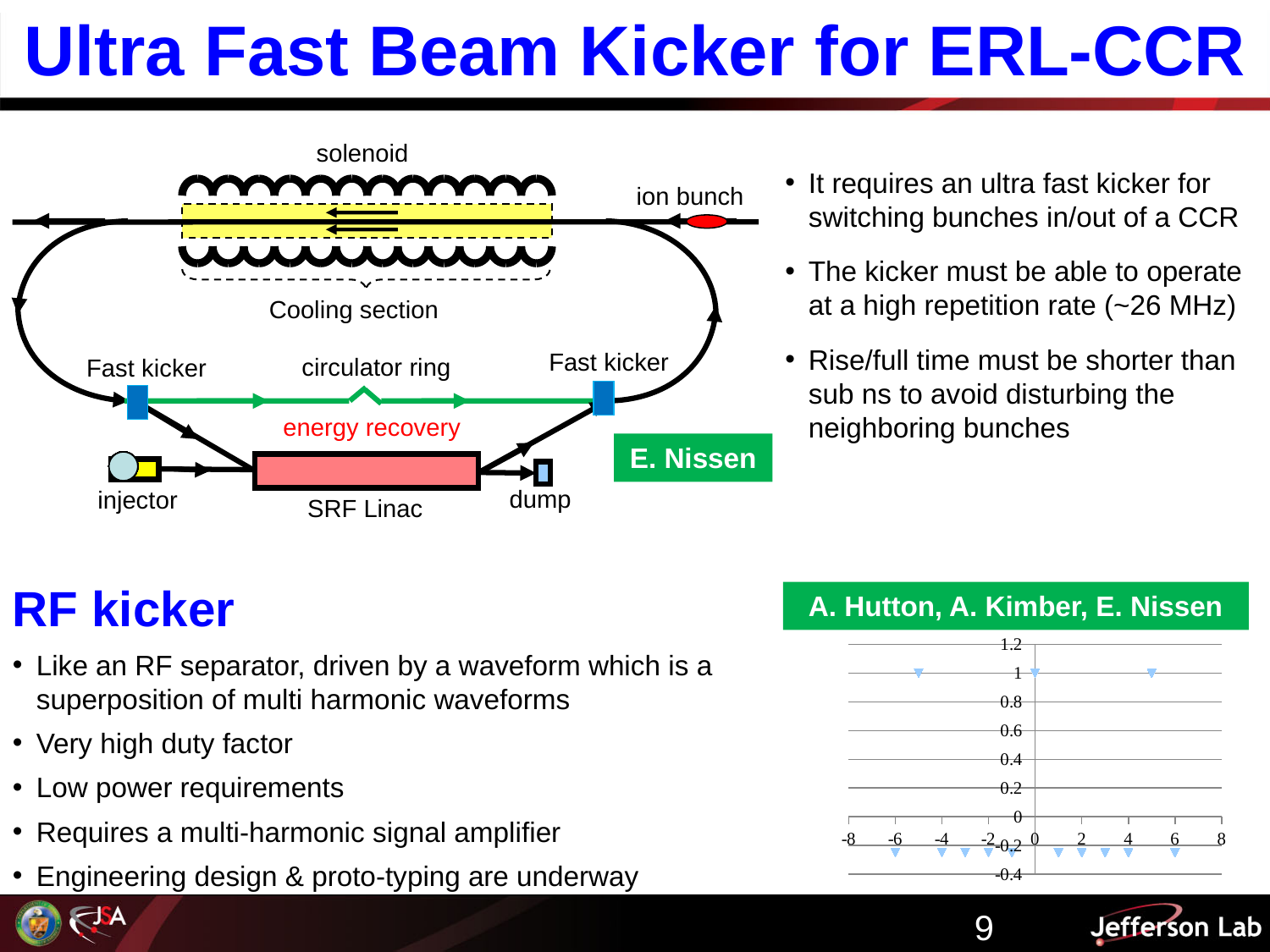
In the bottom-right chart, which point has the larger value: the one at x = 0 or the one at x = 1? x = 0 In the bottom-right chart, is the value of the point at x = -5 greater or less than 0.4? greater In the bottom-right chart, is the value of the point at x = -6 greater or less than 0.2? less What kind of chart is shown at the bottom right of the slide? scatter chart In the bottom-right chart, is the value of the point at x = 2 greater or less than 0? less What is the highest value labelled on the vertical axis of the bottom-right chart? 1.2 In the bottom-right chart, which point has the larger value: the one at x = -4 or the one at x = -5? x = -5 What is the range of the horizontal axis of the bottom-right chart? -8 to 8 In the bottom-right chart, how many points are plotted above the 0.8 gridline? 3